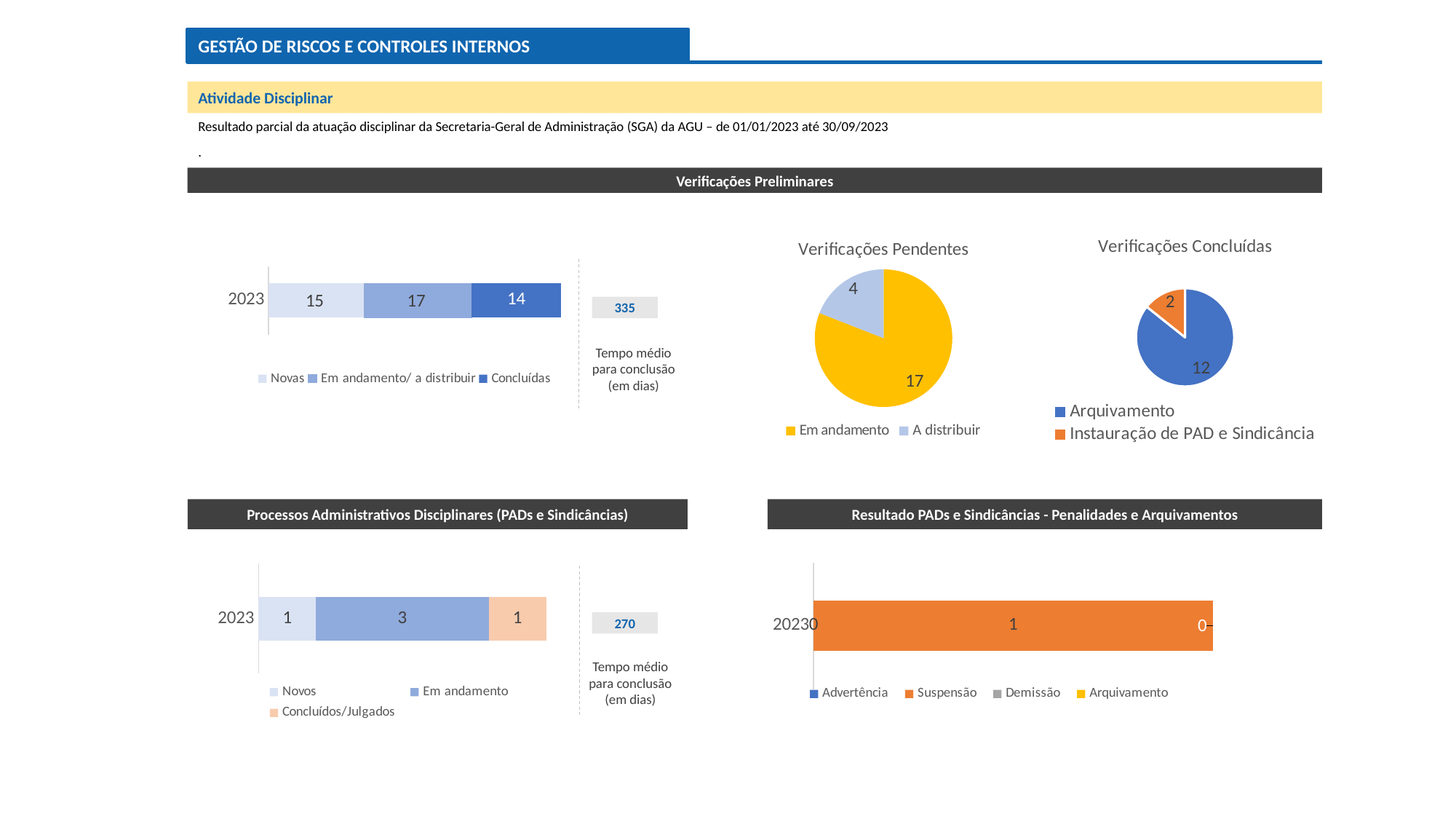
In the 'Verificações Pendentes' pie chart, what is the value for 'Em andamento'? 17 How many series does the legend list in the chart under 'Resultado PADs e Sindicâncias - Penalidades e Arquivamentos'? 4 In the stacked bar chart under 'Processos Administrativos Disciplinares (PADs e Sindicâncias)', what is the value for 'Em andamento' in 2023? 3 In the stacked bar chart under 'Verificações Preliminares' (top left), what is the value for 'Novas' in 2023? 15 In the stacked bar chart under 'Verificações Preliminares' (top left), which series has the highest value in 2023? Em andamento/ a distribuir In the stacked bar chart under 'Verificações Preliminares' (top left), what is the total of the 2023 bar? 46 What kind of chart is 'Verificações Pendentes'? Pie chart In the stacked bar chart under 'Processos Administrativos Disciplinares (PADs e Sindicâncias)', what is the total of the 2023 bar? 5 In the 'Verificações Pendentes' pie chart, what is the value for 'A distribuir'? 4 In the 'Verificações Concluídas' pie chart, which category is the largest? Arquivamento In the 'Verificações Concluídas' pie chart, what is the difference between 'Arquivamento' and 'Instauração de PAD e Sindicância'? 10 In the 'Verificações Concluídas' pie chart, what is the value for 'Arquivamento'? 12